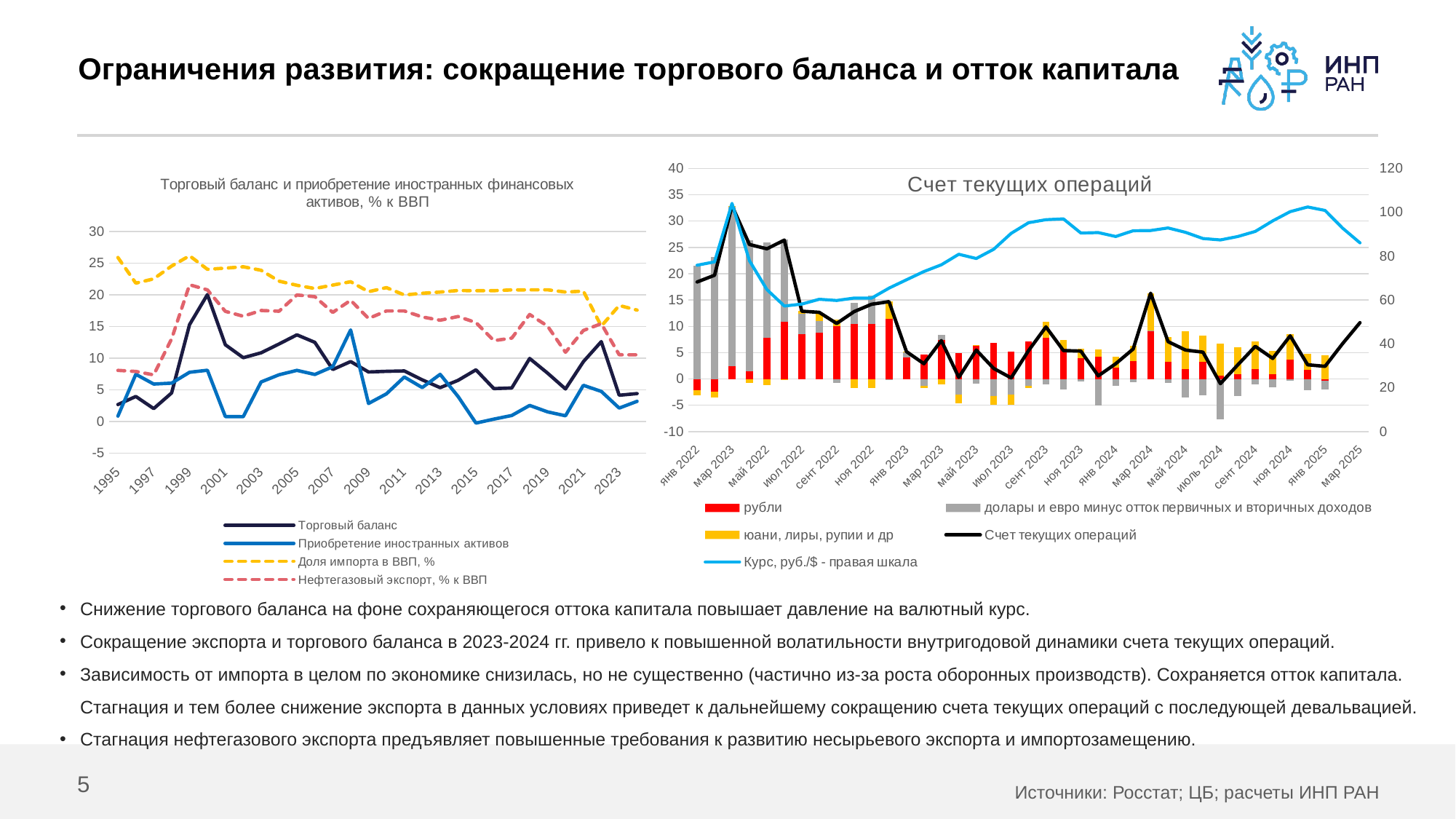
What kind of chart is the left chart, 'Торговый баланс и приобретение иностранных финансовых активов, % к ВВП'? Line chart In the right chart 'Счет текущих операций', is the value of 'Курс, руб./$' in янв 2025 greater or less than 80 on the right scale? greater How many series does the legend of the left chart list? 4 In the left chart, is the value of 'Торговый баланс' in 2023 greater or less than 10? less In the left chart, is the value of 'Доля импорта в ВВП, %' in 1995 greater or less than 20? greater What is the title of the right chart? Счет текущих операций In the left chart, which is larger in 1995: 'Доля импорта в ВВП, %' or 'Торговый баланс'? Доля импорта в ВВП, % In the left chart, does 'Доля импорта в ВВП, %' rise or fall overall from 1999 to 2023? fall How many series does the legend of the right chart 'Счет текущих операций' list? 5 In the right chart 'Счет текущих операций', which series is plotted on the right-hand scale? Курс, руб./$